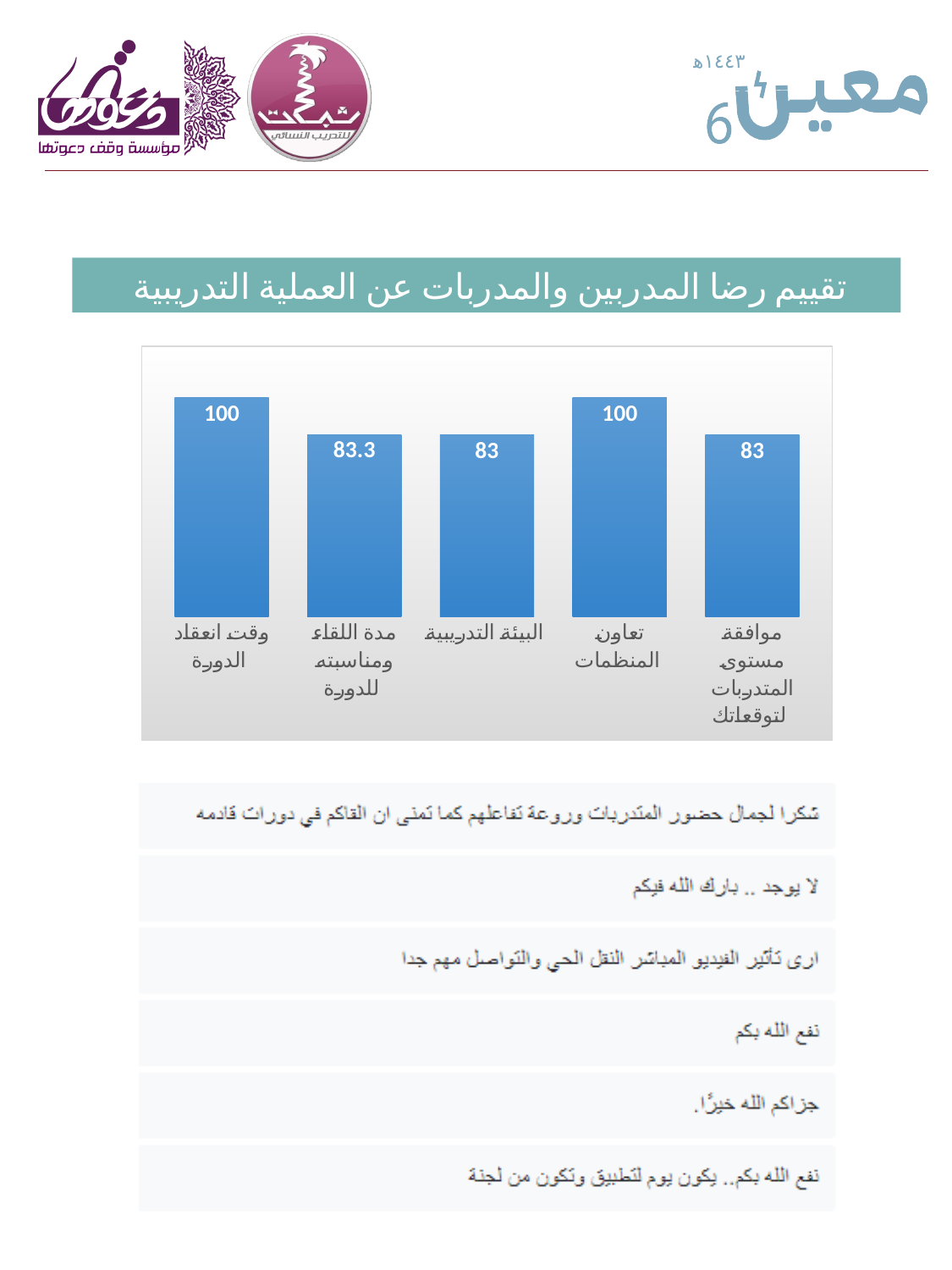
How many categories are shown in the chart? 5 What is the value for مدة اللقاء ومناسبته للدورة? 83.3 What is the difference between the values for وقت انعقاد الدورة and البيئة التدريبية? 17 What is the lowest value shown in the chart? 83 What is the value for تعاون المنظمات? 100 Which is larger, the value for وقت انعقاد الدورة or the value for البيئة التدريبية? وقت انعقاد الدورة What is the difference between the values for تعاون المنظمات and مدة اللقاء ومناسبته للدورة? 16.7 What is the value for وقت انعقاد الدورة? 100 What is the value for موافقة مستوى المتدربات لتوقعاتك? 83 What is the value for البيئة التدريبية? 83 What is the highest value shown in the chart? 100 What kind of chart is shown on the slide? bar chart